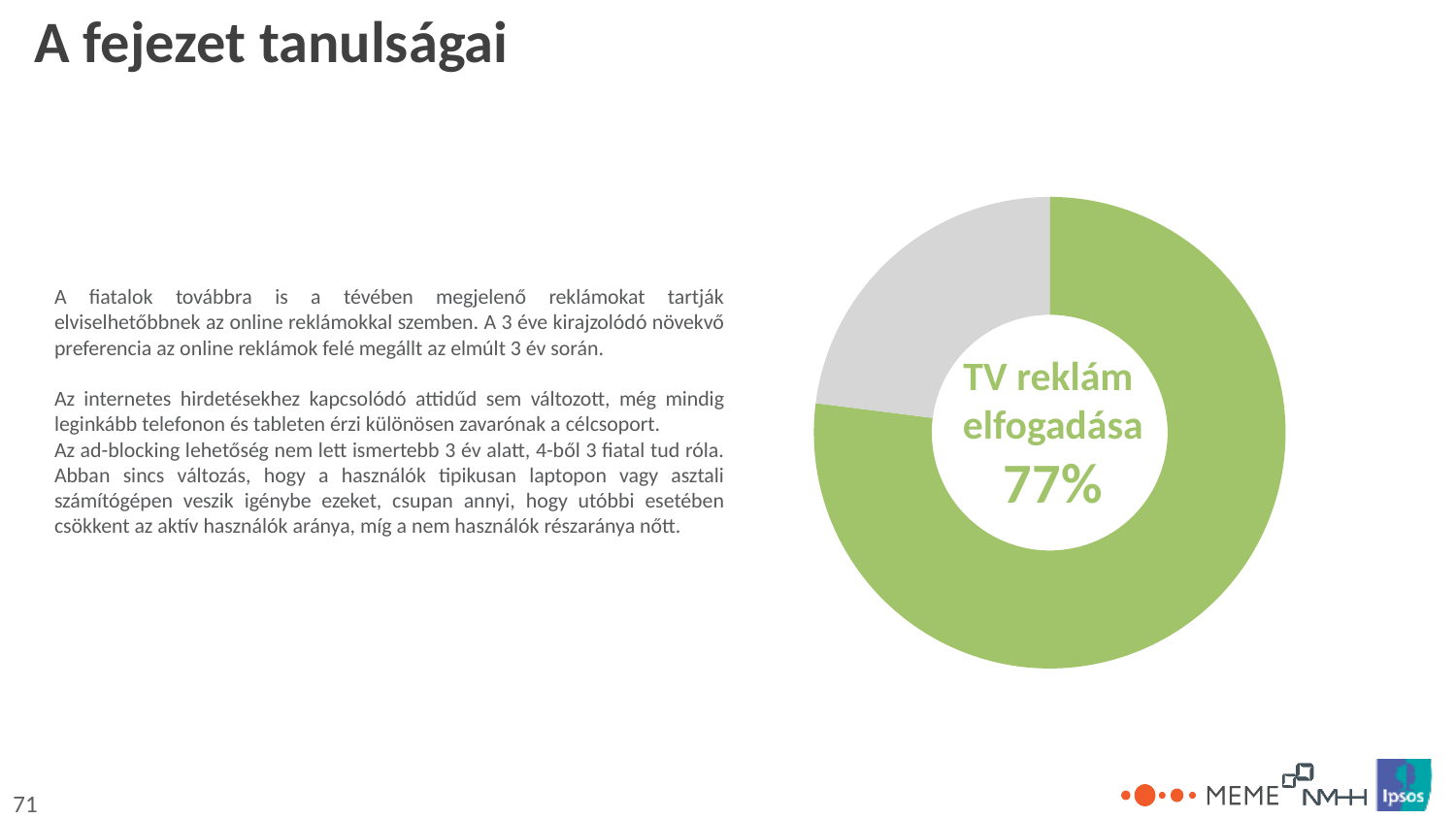
What percentage is printed in the centre of the donut chart? 77% Is the share of the green slice greater or less than 50%? greater What is the label printed in the centre of the donut chart? TV reklám elfogadása Is the share of the grey slice greater or less than 50%? less How many slices does the donut chart have? 2 Which slice of the donut chart is larger, the green one or the grey one? green What kind of chart is shown on the slide? pie (donut) chart What share of the donut chart does the green slice represent? 77% What colour is the largest slice of the donut chart? green